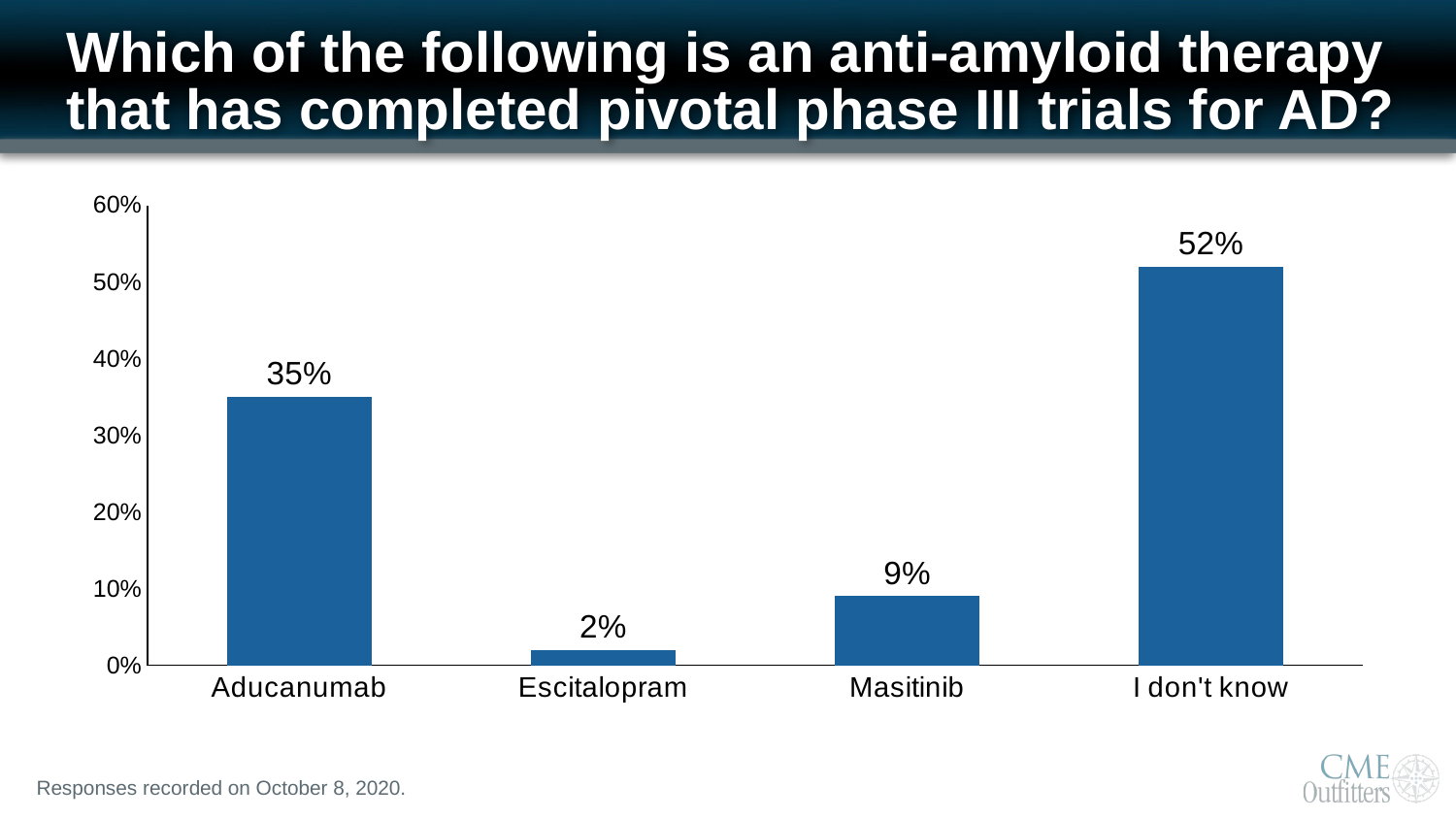
What percentage of respondents chose Aducanumab? 35% Which received a larger share of responses, Aducanumab or Masitinib? Aducanumab How many response options are shown on the chart? 4 Which response option received the lowest percentage? Escitalopram What percentage of respondents chose Escitalopram? 2% Which response option received the highest percentage? I don't know What percentage of respondents chose Masitinib? 9% What percentage of respondents answered 'I don't know'? 52% What is the difference in percentage points between Masitinib and Escitalopram? 7 What is the difference in percentage points between 'I don't know' and Aducanumab? 17 Is the value for 'I don't know' greater or less than 50%? greater What type of chart is shown on the slide? Bar chart